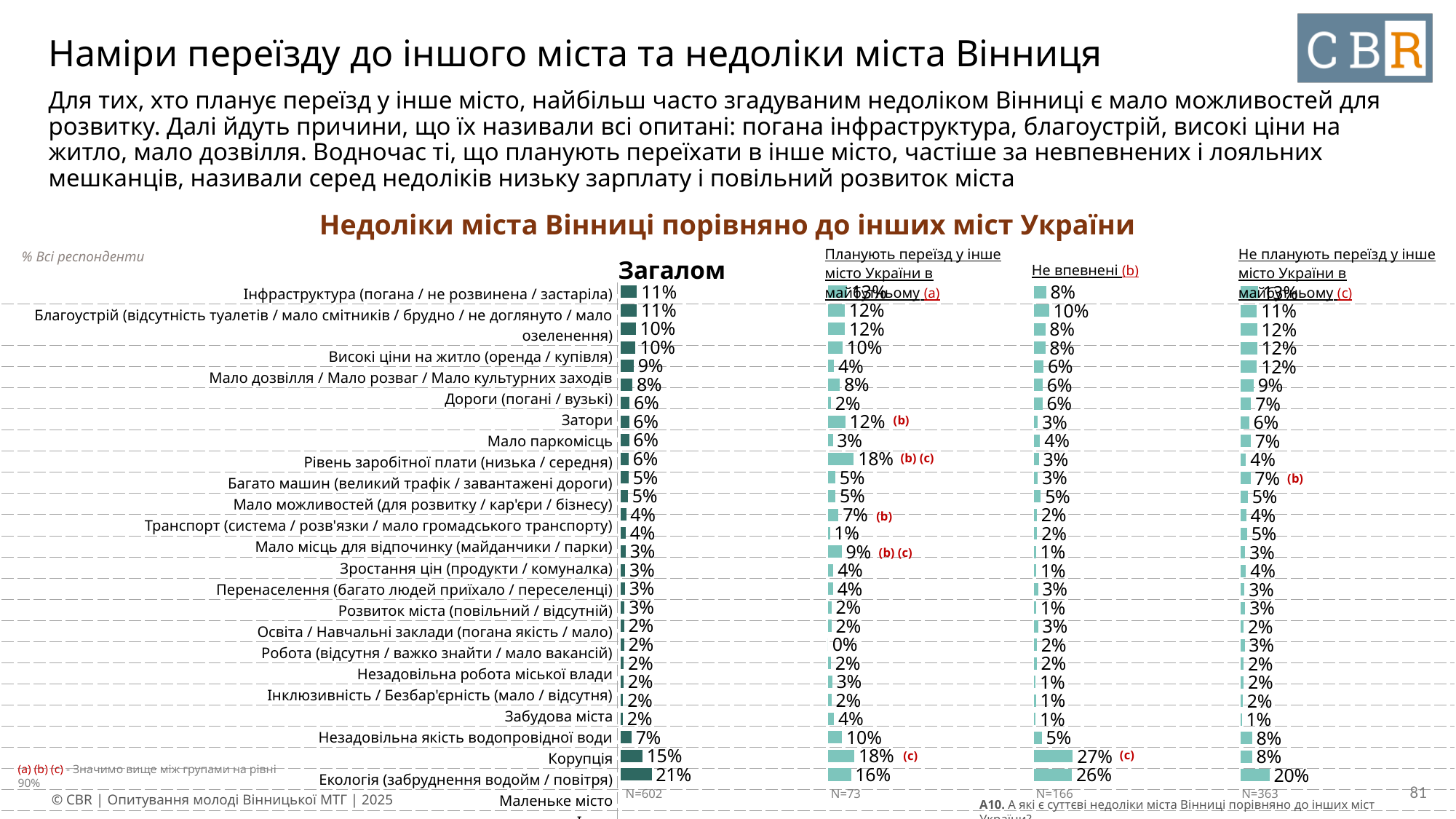
What kind of chart is shown on the slide? Bar chart What is the title of the chart? Недоліки міста Вінниці порівняно до інших міст України What is the sample size (N) shown for the Планують переїзд group? N=73 What is the value for Інфраструктура (погана / не розвинена / застаріла) in the Не впевнені column? 8% What is the lowest value shown in the Планують переїзд column? 0% For Інфраструктура, which is larger: the Не впевнені value or the Не планують переїзд value? Не планують переїзд What is the highest value shown in the Загалом column? 21% How many respondent groups (columns of bars) does the chart show? 4 What is the highest value shown in the Не планують переїзд column? 20% What is the value for Інфраструктура (погана / не розвинена / застаріла) in the Загалом column? 11% For Інфраструктура, what is the difference between the Не планують переїзд value (13%) and the Не впевнені value (8%)? 5 percentage points What is the highest value shown in the Не впевнені column? 27%